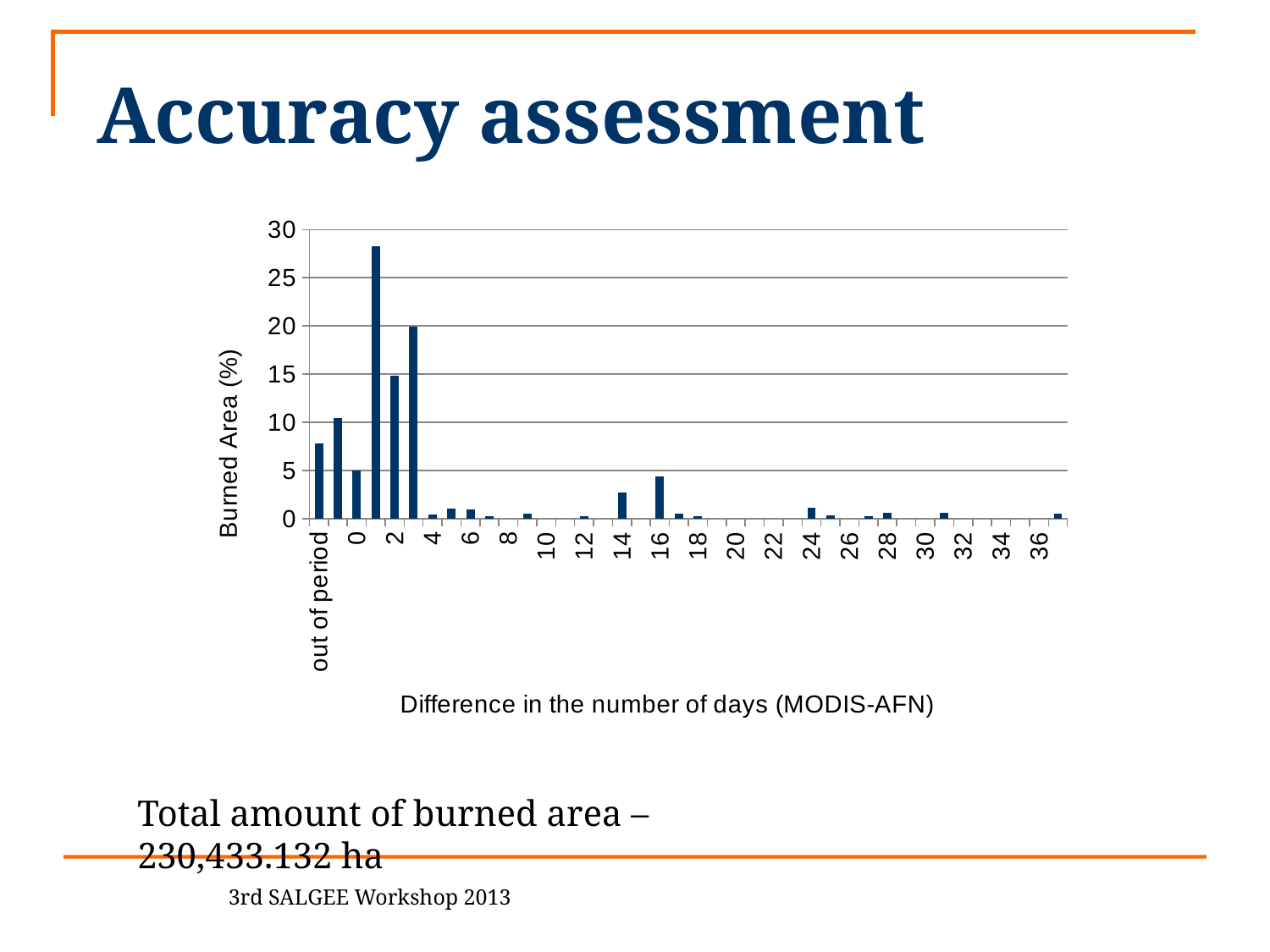
Is the value for 24 greater or less than 5? less Is the tallest bar in the chart greater or less than 25? greater What is the title of the horizontal axis of the chart? Difference in the number of days (MODIS-AFN) Is the value for 16 greater or less than 5? less Which has the larger value, 2 or 16? 2 Which has the larger value, "out of period" or 16? out of period What is the title of the vertical axis of the chart? Burned Area (%) What kind of chart is shown on the slide? bar chart Which has the larger value, 14 or 24? 14